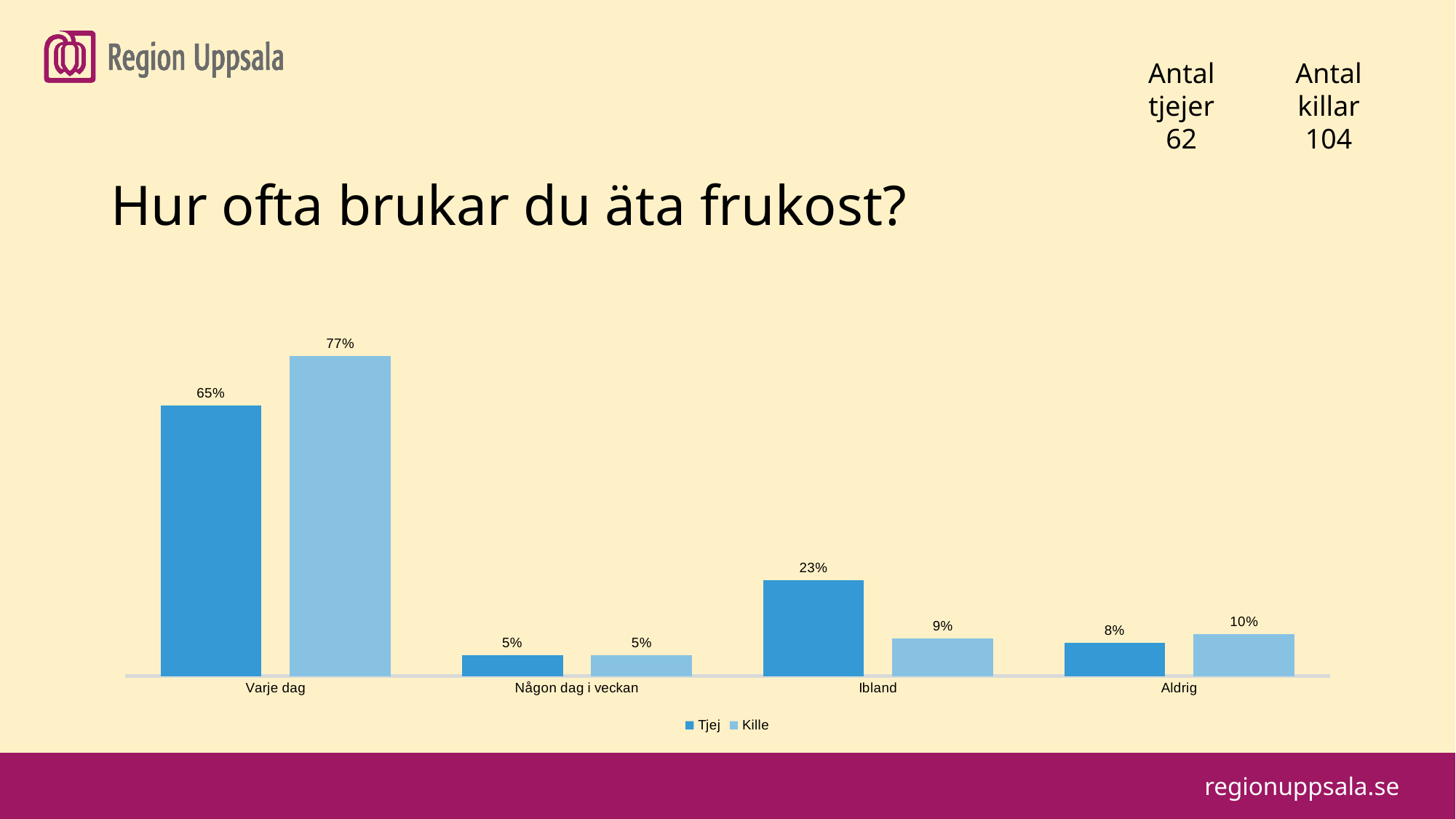
What is the value for Kille in the Aldrig category? 10% What is the value for Kille in the Varje dag category? 77% What is the difference between the Kille and Tjej values in the Varje dag category? 12% Which category has the lowest value for Tjej? Någon dag i veckan What kind of chart is shown on the slide? Bar chart How many categories are shown on the x axis? 4 What is the title of the chart? Hur ofta brukar du äta frukost? How many series does the legend list? 2 What is the value for Tjej in the Varje dag category? 65% In the Ibland category, which series has the larger value, Tjej or Kille? Tjej What is the value for Tjej in the Ibland category? 23% Which category has the highest value for Kille? Varje dag